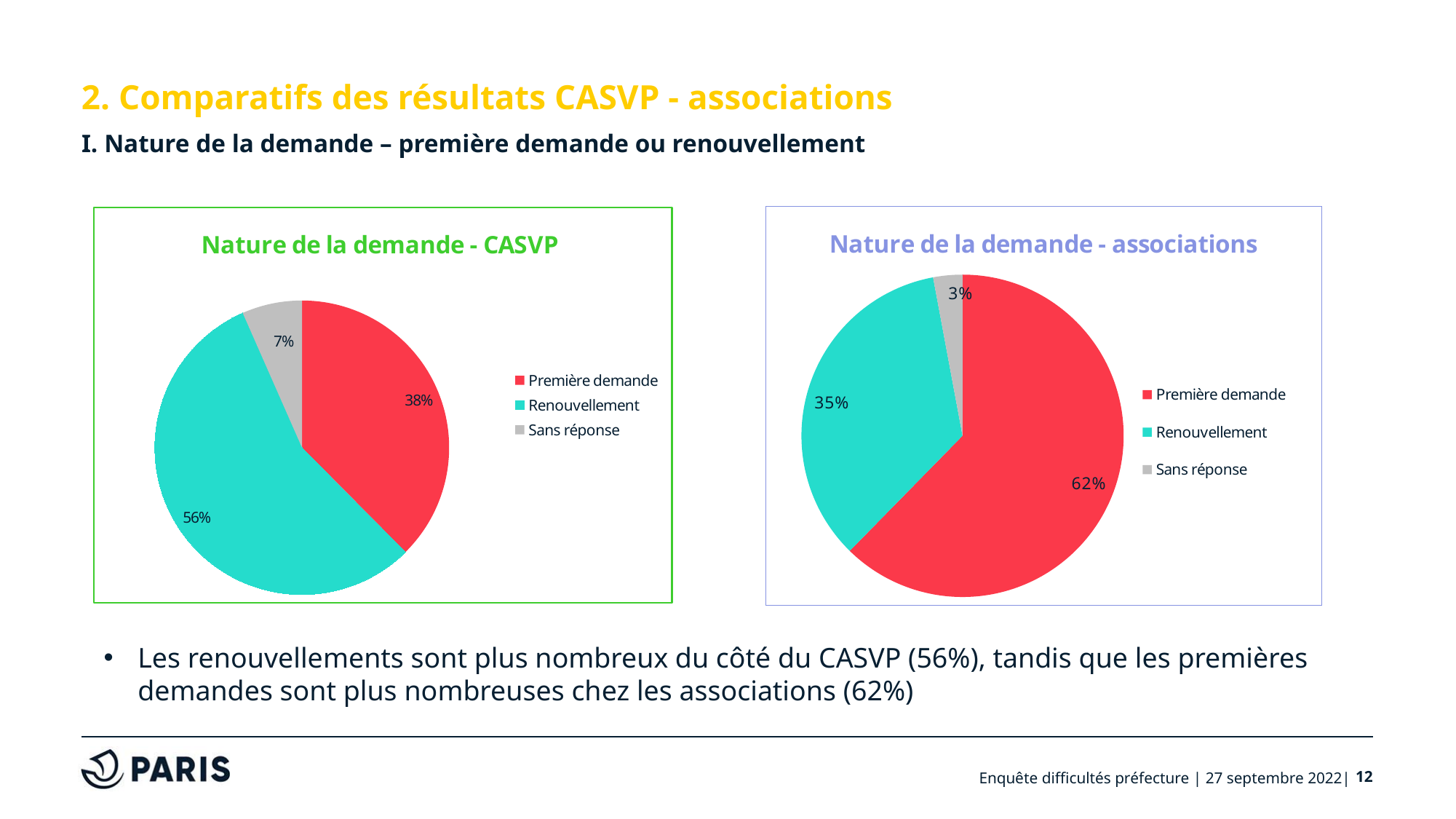
In the 'Nature de la demande - CASVP' chart, what is the difference between Renouvellement and Sans réponse? 49% In the 'Nature de la demande - CASVP' chart, which category has the largest slice? Renouvellement How many categories does the legend of the 'Nature de la demande - associations' chart list? 3 In the 'Nature de la demande - associations' chart, what share does Première demande have? 62% In the 'Nature de la demande - CASVP' chart, which colour represents Sans réponse? Grey What type of chart is 'Nature de la demande - CASVP'? Pie chart Is the Première demande share larger in the 'Nature de la demande - CASVP' chart or in the 'Nature de la demande - associations' chart? Nature de la demande - associations In the 'Nature de la demande - CASVP' chart, what share does Première demande have? 38% In the 'Nature de la demande - CASVP' chart, what share does Renouvellement have? 56% In the 'Nature de la demande - associations' chart, which category has the smallest slice? Sans réponse In the 'Nature de la demande - associations' chart, what share does Sans réponse have? 3% In the 'Nature de la demande - associations' chart, what is the difference between Première demande and Renouvellement? 27%